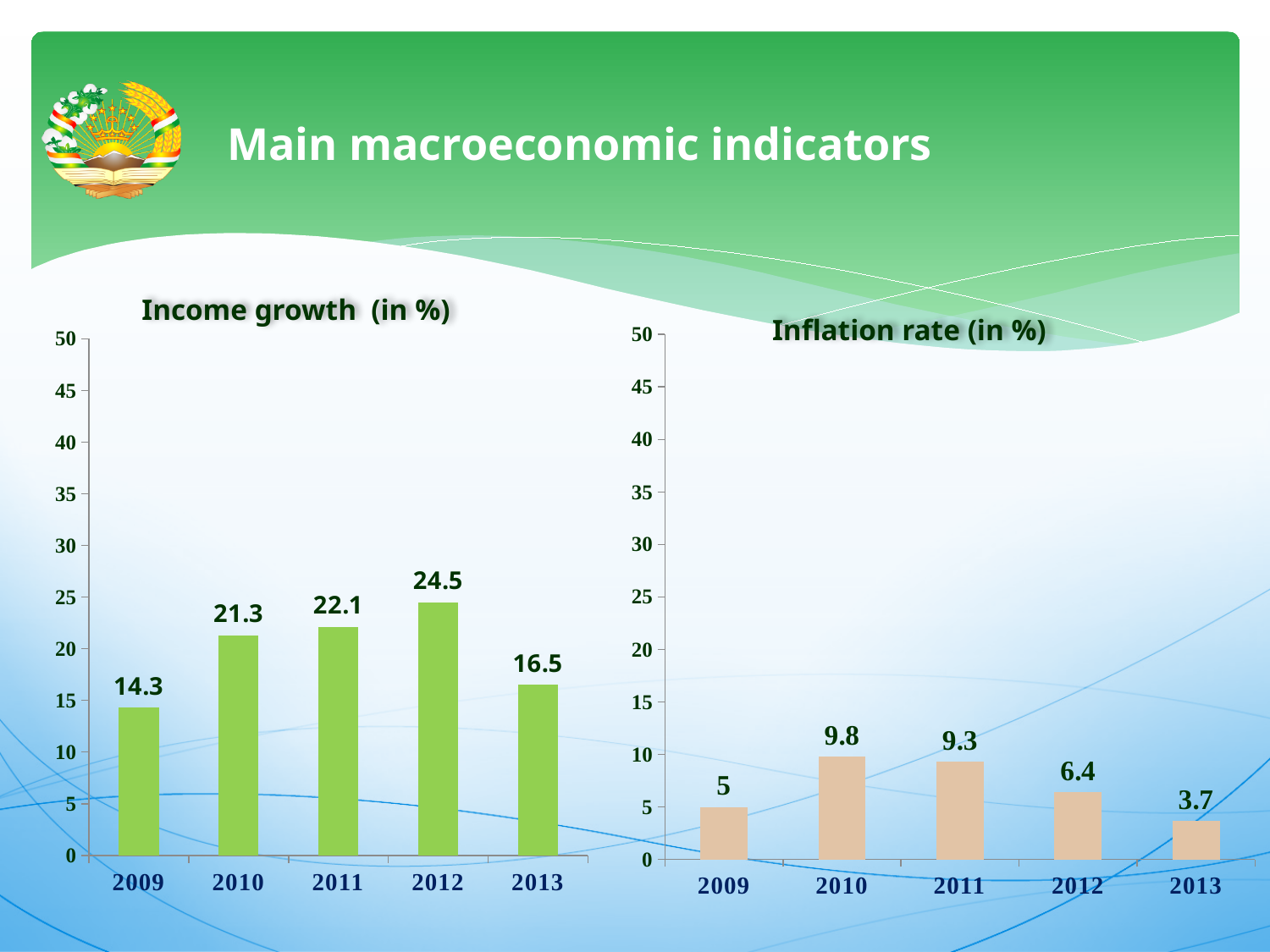
In the Income growth (in %) chart, which year has the highest value? 2012 In the Inflation rate (in %) chart, is the value for 2012 greater or less than 5? greater In the Income growth (in %) chart, what is the difference between the values for 2012 and 2013? 8 In the Inflation rate (in %) chart, which year has the lowest value? 2013 In the Income growth (in %) chart, what is the value for 2012? 24.5 In the Income growth (in %) chart, which is larger, the value for 2010 or the value for 2013? 2010 What kind of chart is the Income growth (in %) chart? bar chart In the Inflation rate (in %) chart, what is the difference between the values for 2010 and 2011? 0.5 In the Inflation rate (in %) chart, what is the value for 2010? 9.8 How many years are shown in the Inflation rate (in %) chart? 5 In the Inflation rate (in %) chart, do the values rise or fall from 2010 to 2013? fall What is the title of the chart on the left side of the slide? Income growth (in %)